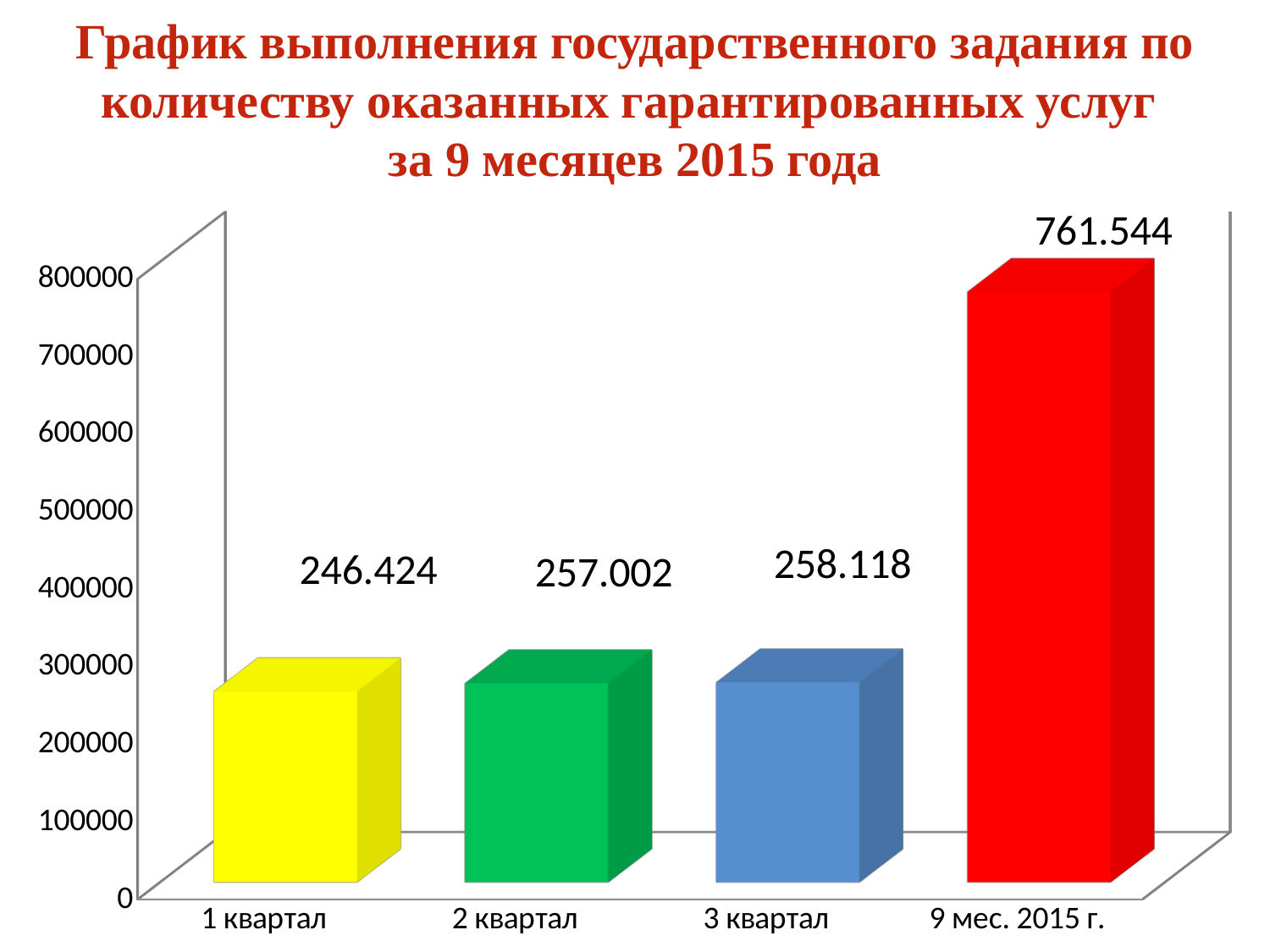
What is the value shown for 9 мес. 2015 г.? 761.544 What kind of chart is shown on the slide? bar chart What is the value shown for 1 квартал? 246.424 Is the value for 1 квартал greater or less than 300000? less What is the difference between the values for 2 квартал and 1 квартал? 10.578 Which category has the highest value? 9 мес. 2015 г. Which is larger, the value for 3 квартал or the value for 9 мес. 2015 г.? 9 мес. 2015 г. Which category has the lowest value? 1 квартал What is the value shown for 2 квартал? 257.002 What is the difference between the values for 9 мес. 2015 г. and 3 квартал? 503.426 How many categories are shown on the x axis? 4 What is the value shown for 3 квартал? 258.118